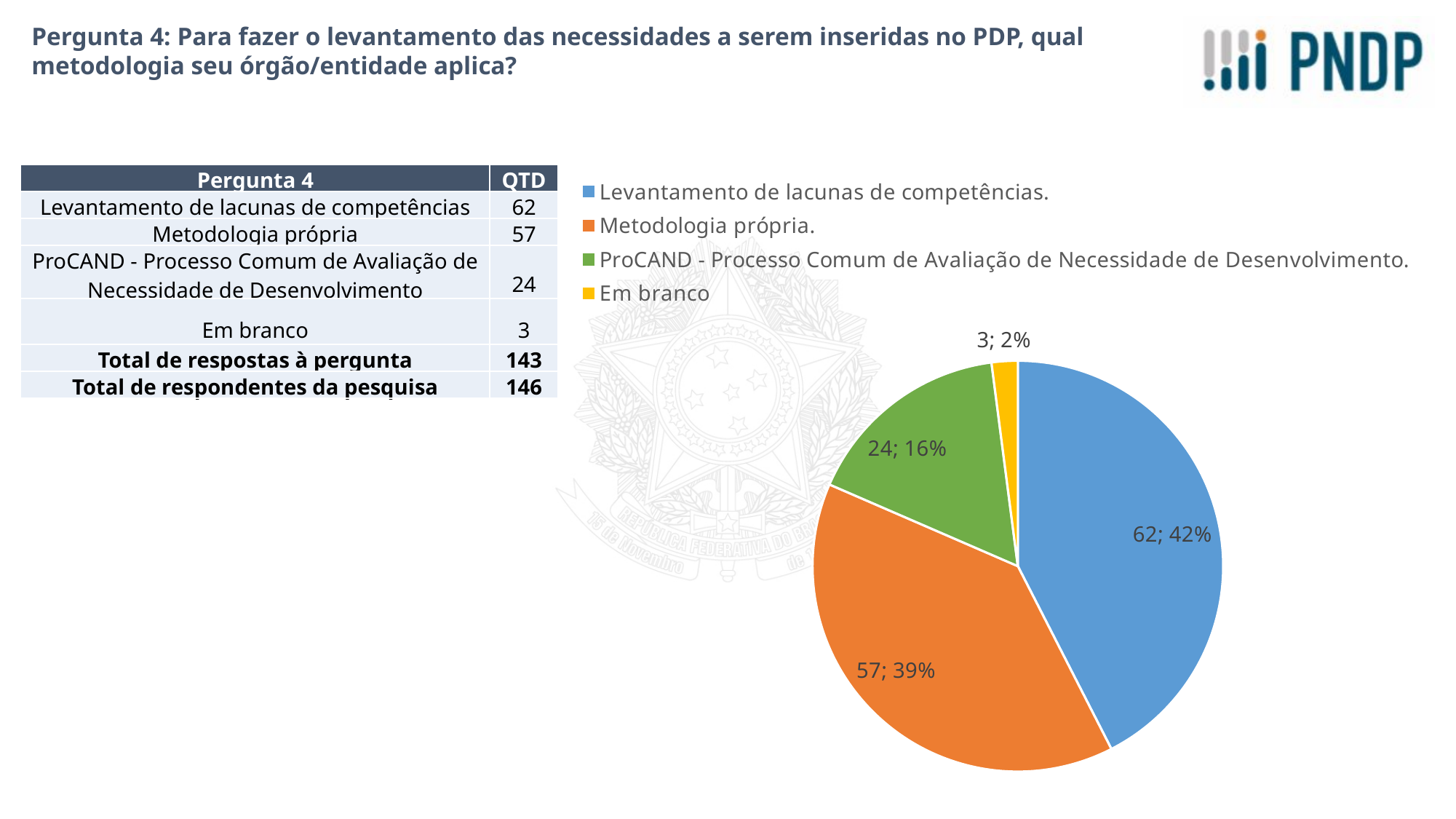
What is the difference between the values for 'Levantamento de lacunas de competências' and 'ProCAND - Processo Comum de Avaliação de Necessidade de Desenvolvimento'? 38 How many slices does the pie chart have? 4 Which colour represents 'Em branco' in the pie chart? yellow What share of the pie does 'Metodologia própria' represent? 39% What is the value shown for 'ProCAND - Processo Comum de Avaliação de Necessidade de Desenvolvimento' in the pie chart? 24 What is the value shown for 'Levantamento de lacunas de competências' in the pie chart? 62 What kind of chart is shown on the slide? pie chart How many entries does the legend of the pie chart list? 4 Which category has the smallest slice in the pie chart? Em branco What is the value shown for 'Em branco' in the pie chart? 3 What is the value shown for 'Metodologia própria' in the pie chart? 57 Which category has the largest slice in the pie chart? Levantamento de lacunas de competências